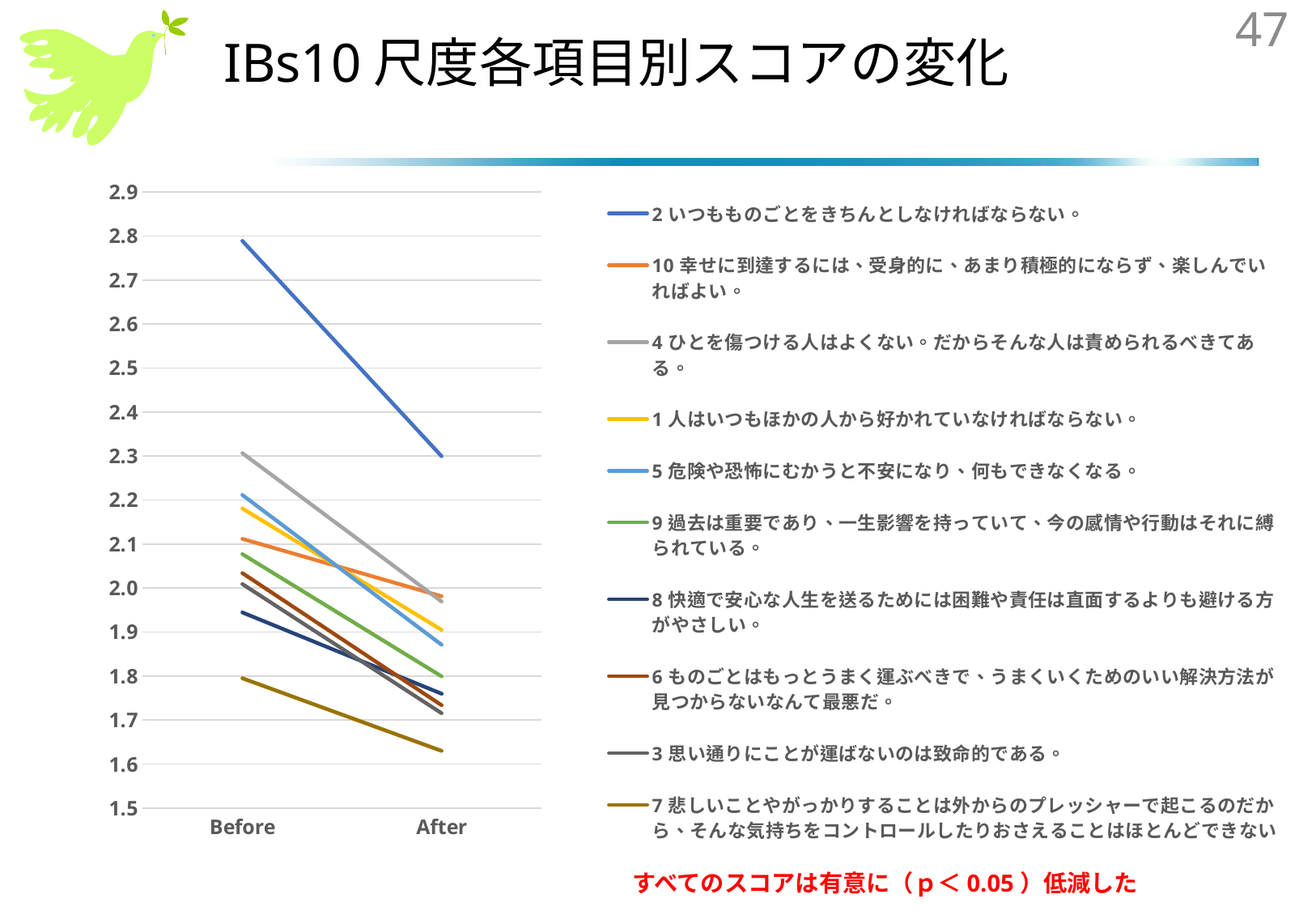
Which series has the lowest value at Before? 7 悲しいことやがっかりすることは外からのプレッシャーで起こるのだから、そんな気持ちをコントロールしたりおさえることはほとんどできない What are the two categories on the x axis? Before, After How many categories are on the x axis? 2 Do the values rise or fall from Before to After? fall Which series has the lowest value at After? 7 悲しいことやがっかりすることは外からのプレッシャーで起こるのだから、そんな気持ちをコントロールしたりおさえることはほとんどできない Is the Before value for series 4 (ひとを傷つける人はよくない) greater or less than 2.2? greater Is the After value for series 7 (悲しいことやがっかりすること...) greater or less than 1.7? less Which series has the highest value at Before? 2 いつもものごとをきちんとしなければならない。 Is the Before value for series 2 (いつもものごとをきちんとしなければならない) greater or less than 2.7? greater At After, which is larger: series 2 (いつもものごとをきちんとしなければならない) or series 4 (ひとを傷つける人はよくない)? series 2 How many series does the legend list? 10 What kind of chart is shown on the slide? line chart